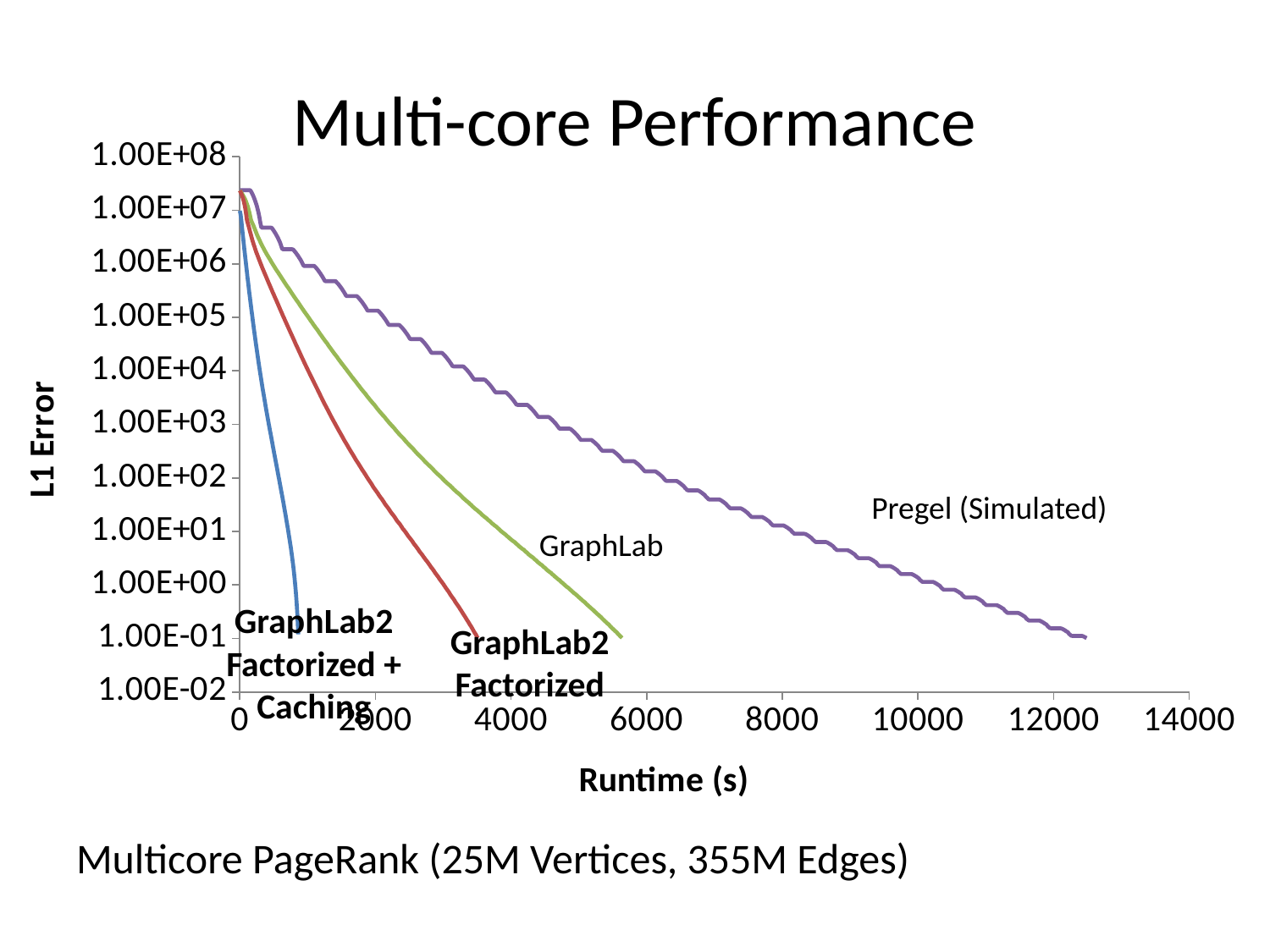
What is the label of the x axis? Runtime (s) Which series takes the longest runtime to reach its lowest L1 Error? Pregel (Simulated) How many series (lines) are plotted on the chart? 4 Is the runtime at which the GraphLab2 Factorized + Caching line ends greater or less than 2000 s? less Is the runtime at which the GraphLab line ends greater or less than 6000 s? less As runtime increases, does the L1 Error for each series rise or fall? fall Which series reaches its lowest L1 Error in the shortest runtime? GraphLab2 Factorized + Caching Which series takes longer to reach an L1 Error of about 1.00E-01: GraphLab or Pregel (Simulated)? Pregel (Simulated) Is the runtime at which the Pregel (Simulated) line ends greater or less than 12000 s? greater What kind of chart is shown on the slide? line chart Which series converges faster: GraphLab2 Factorized or GraphLab? GraphLab2 Factorized What is the title of the chart? Multi-core Performance